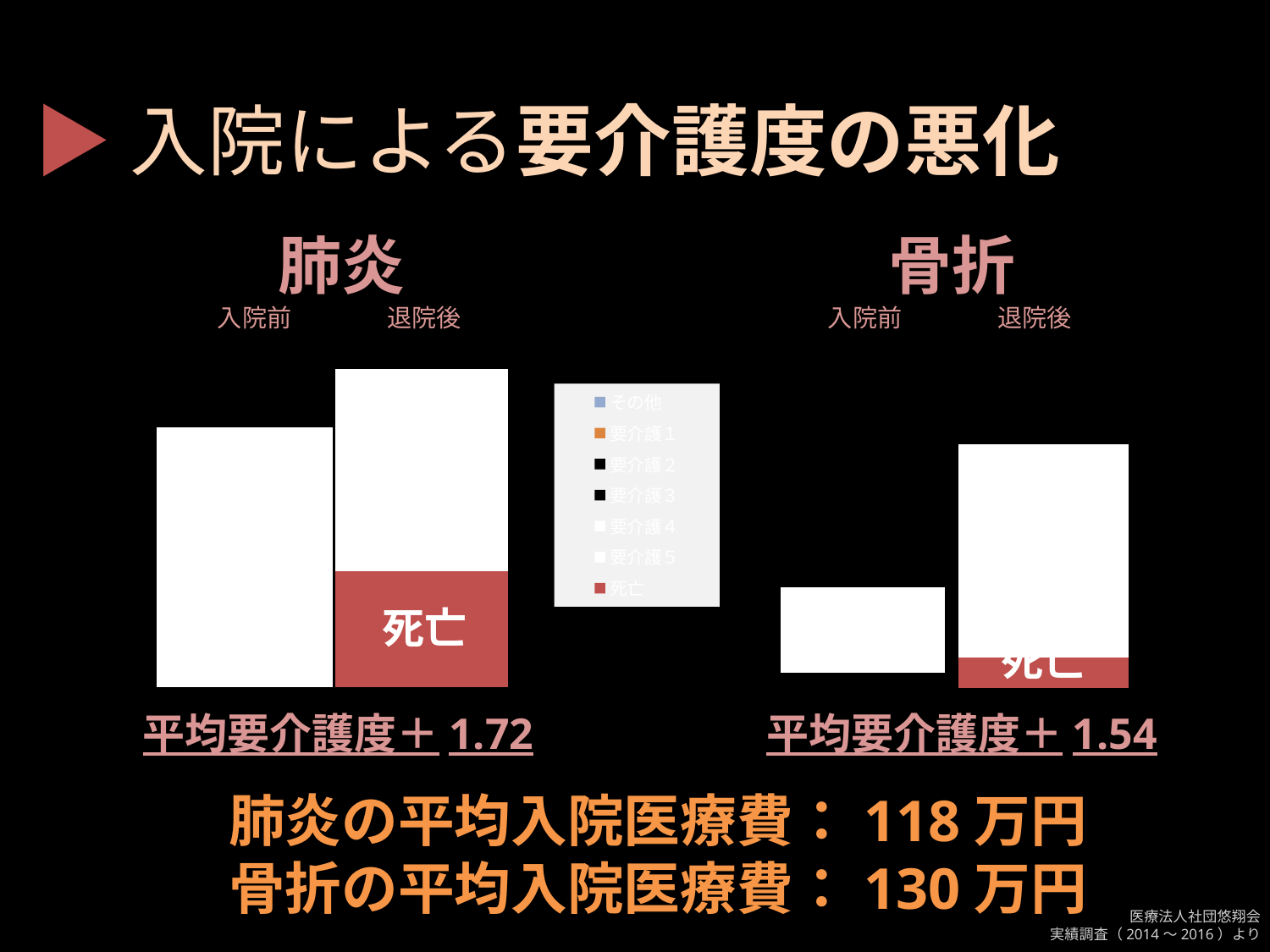
How many bars does the 肺炎 chart show? 2 What is the last entry listed in the legend? 死亡 Which chart has the larger 死亡 segment in its 退院後 bar, 肺炎 or 骨折? 肺炎 How many entries does the legend between the two charts list? 7 What kind of chart is the 骨折 chart? stacked bar chart How many bars does the 骨折 chart show? 2 In the 肺炎 chart, which bar contains the 死亡 segment? 退院後 In the 骨折 chart, which bar is taller, 入院前 or 退院後? 退院後 In the 骨折 chart, which bar contains the 死亡 segment? 退院後 What colour is the 死亡 segment in the charts? red What kind of chart is the 肺炎 chart? stacked bar chart In the 肺炎 chart, which bar is taller, 入院前 or 退院後? 退院後